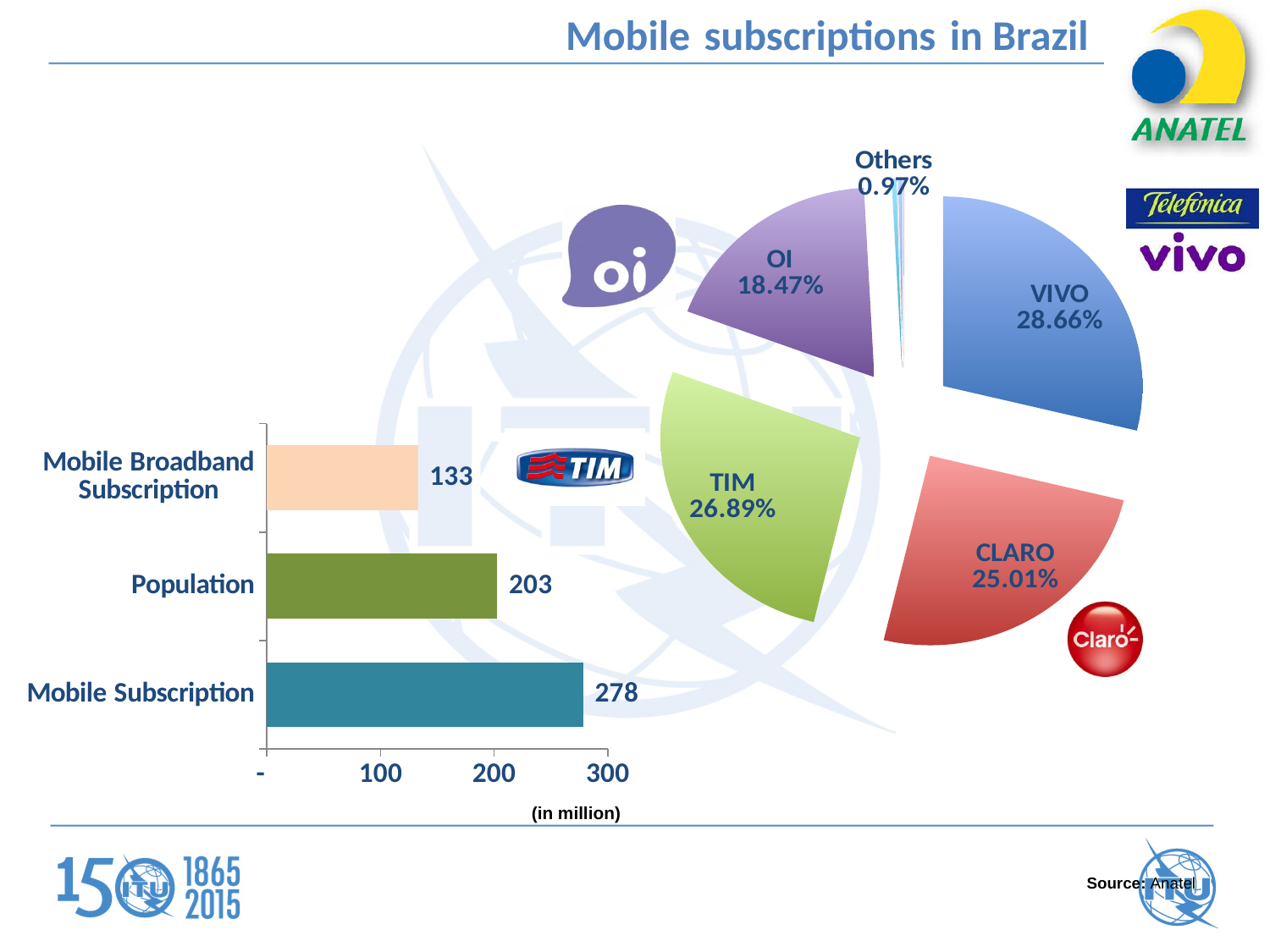
On the pie chart on the right, what share does VIVO have? 28.66% On the bar chart at the bottom left, what is the value for Mobile Subscription? 278 On the bar chart at the bottom left, which category has the highest value? Mobile Subscription On the bar chart at the bottom left, what is the value for Population? 203 On the pie chart on the right, which slice is larger, TIM or CLARO? TIM On the bar chart at the bottom left, what is the difference between Mobile Subscription and Population? 75 What kind of chart is the one at the bottom left of the slide? Bar chart On the bar chart at the bottom left, which category has the lowest value? Mobile Broadband Subscription On the pie chart on the right, which operator has the largest share? VIVO On the bar chart at the bottom left, what is the value for Mobile Broadband Subscription? 133 On the bar chart at the bottom left, how many categories are shown? 3 On the pie chart on the right, what share does OI have? 18.47%